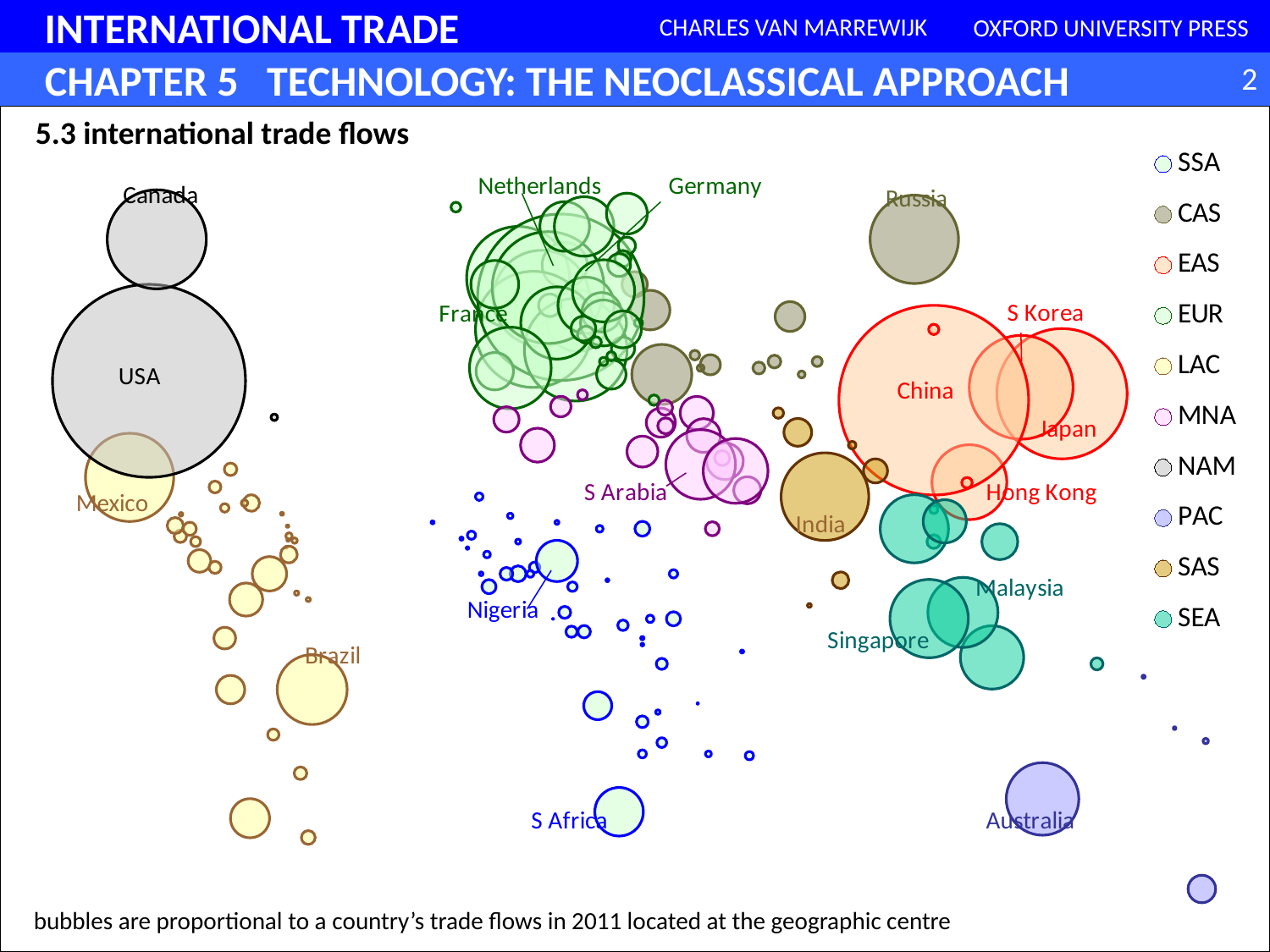
What kind of chart is shown on the slide? bubble chart Which bubble is larger, China or Japan? China Which bubble is larger, USA or Canada? USA Which legend entry is shown in green? EUR What are the bubble sizes proportional to, according to the note at the bottom of the chart? a country's trade flows in 2011 How many region entries does the legend list? 10 Which country has the largest bubble among the red (EAS) bubbles? China Which bubble is larger, Australia or S Africa? Australia